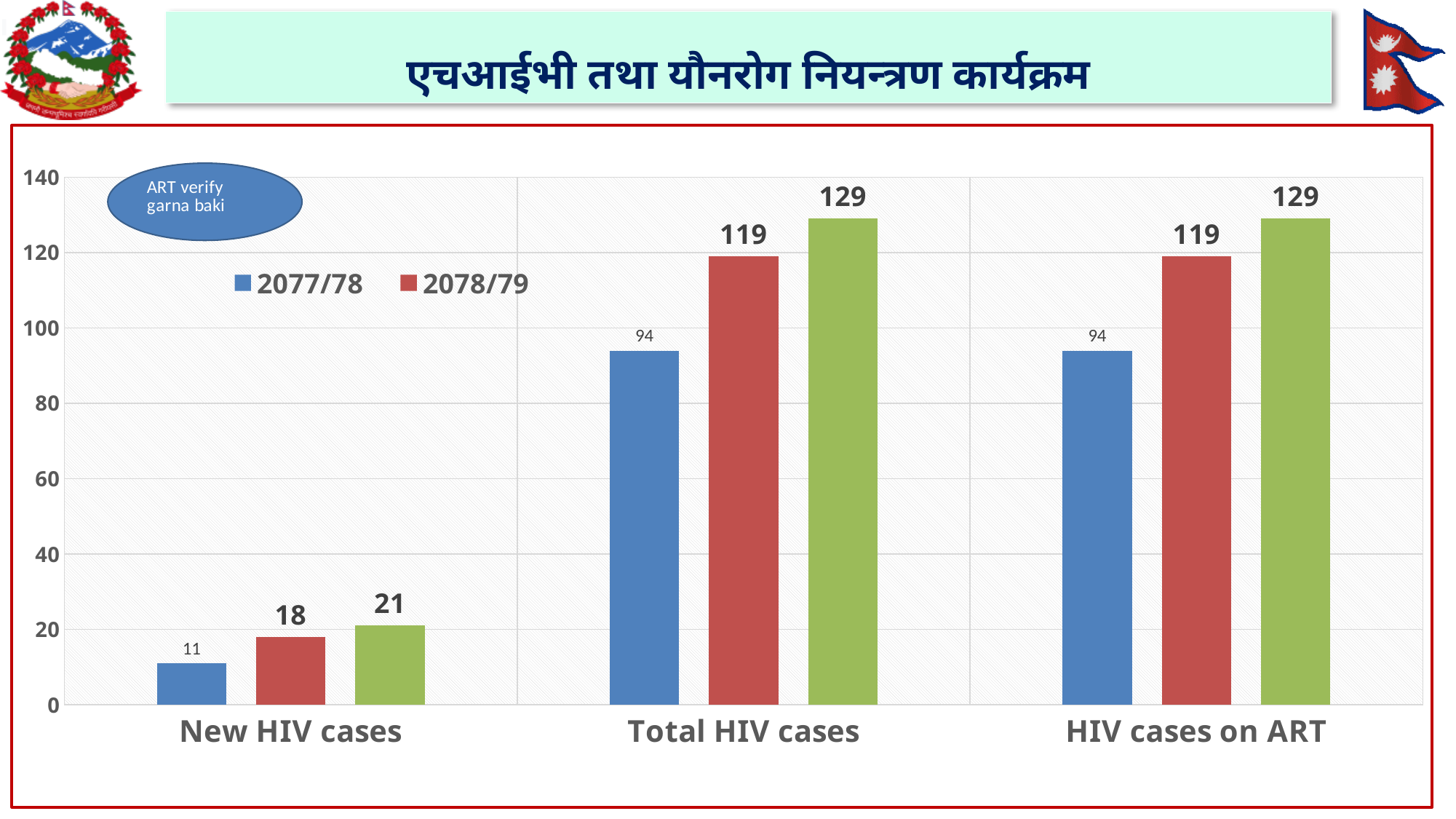
How many series does the legend list? 2 What is the difference between the 2078/79 and 2077/78 values for Total HIV cases? 25 What is the value for 2078/79 in the Total HIV cases category? 119 What is the value for 2077/78 in the New HIV cases category? 11 Is the 2078/79 value for HIV cases on ART greater or less than 100? greater How many categories are shown on the x axis? 3 What is the difference between the 2078/79 and 2077/78 values for New HIV cases? 7 What is the value for 2077/78 in the HIV cases on ART category? 94 What is the value for 2078/79 in the New HIV cases category? 18 Which category has the lowest value for 2077/78? New HIV cases What kind of chart is shown on the slide? bar chart Which is larger: the 2077/78 value for Total HIV cases or the 2078/79 value for New HIV cases? 2077/78 value for Total HIV cases